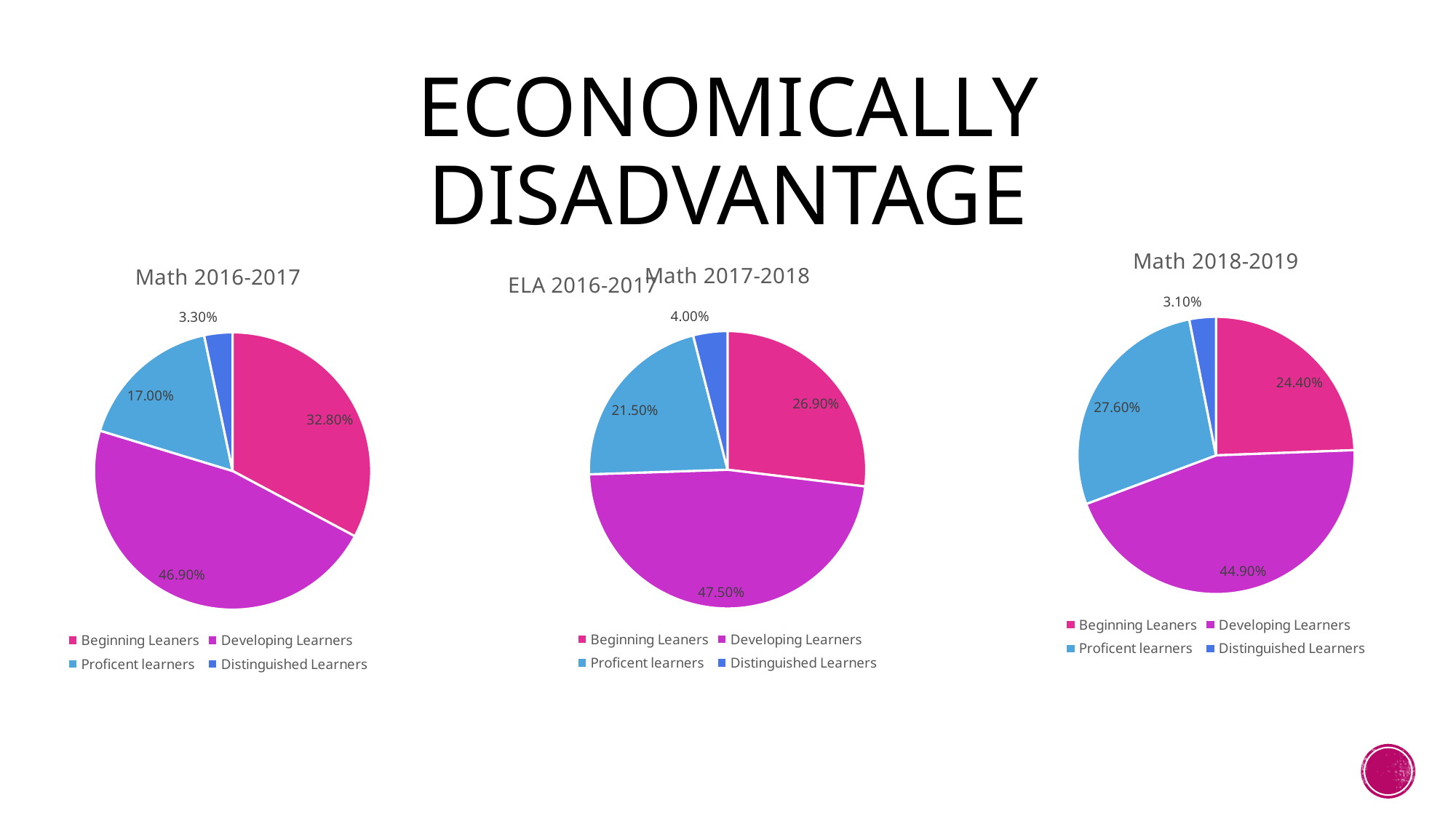
In the Math 2018-2019 pie chart, what percentage is shown for Proficent learners? 27.60% In the Math 2016-2017 pie chart, which category has the largest slice? Developing Learners In the Math 2016-2017 pie chart, what percentage is shown for Distinguished Learners? 3.30% In the Math 2016-2017 pie chart, what percentage is shown for Developing Learners? 46.90% In the middle pie chart, what percentage is shown for Proficent learners? 21.50% In the middle pie chart, what percentage is shown for Beginning Leaners? 26.90% In the Math 2016-2017 pie chart, what is the difference between the Beginning Leaners and Proficent learners percentages? 15.80% How many categories does the legend of the Math 2018-2019 pie chart list? 4 What type of chart is used for Math 2016-2017? Pie chart In the Math 2018-2019 pie chart, which category has the largest slice? Developing Learners In the Math 2016-2017 pie chart, which category has the smallest slice? Distinguished Learners In the middle pie chart, which is larger: the Beginning Leaners slice or the Proficent learners slice? Beginning Leaners